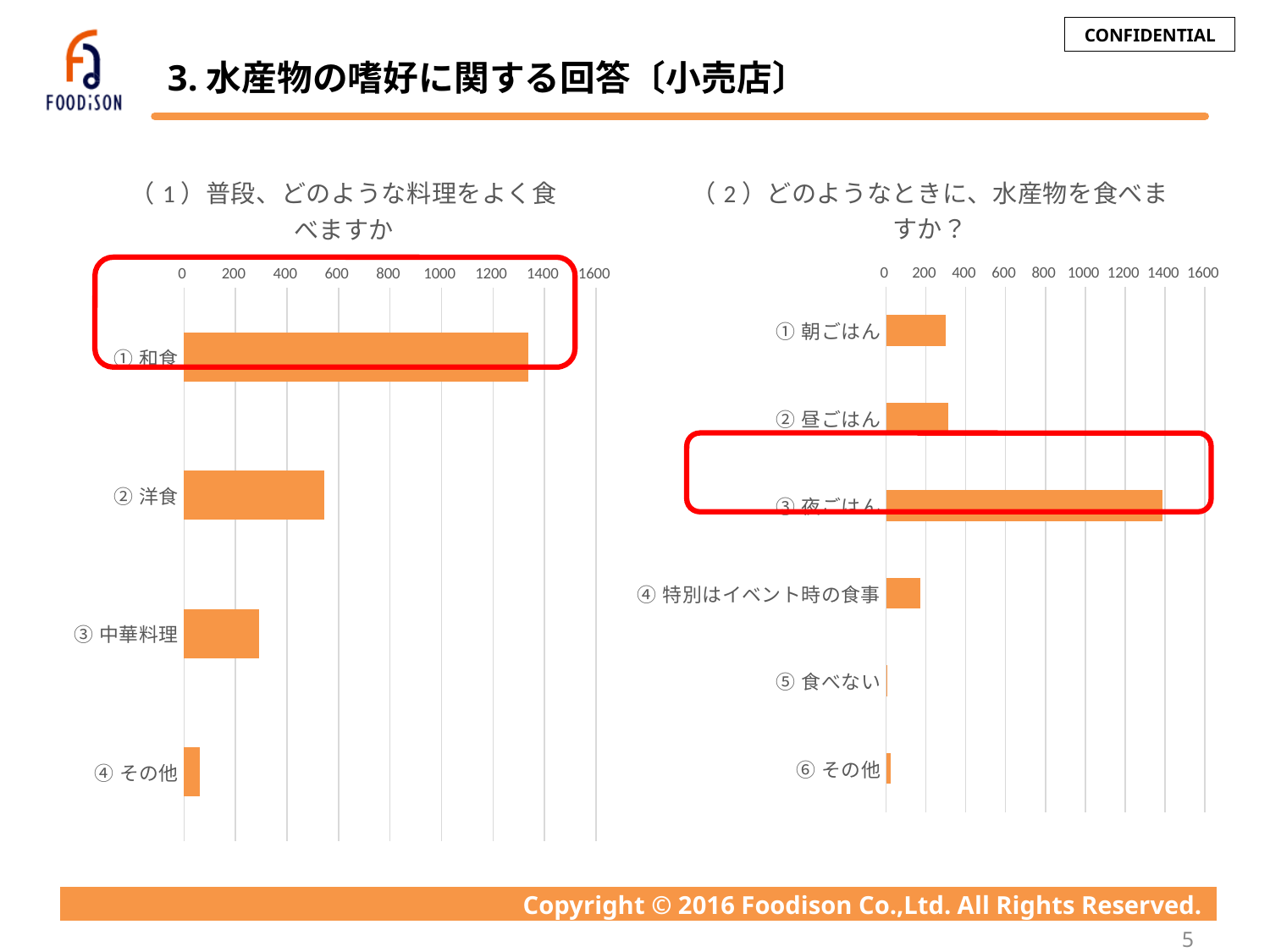
How many categories does the left chart, （1）普段、どのような料理をよく食べますか, show? 4 In the right chart, （2）どのようなときに、水産物を食べますか？, which is larger, ① 朝ごはん or ④ 特別はイベント時の食事? ① 朝ごはん How many categories does the right chart, （2）どのようなときに、水産物を食べますか？, show? 6 In the left chart, （1）普段、どのような料理をよく食べますか, is the value for ② 洋食 greater or less than 800? less In the right chart, （2）どのようなときに、水産物を食べますか？, is the value for ③ 夜ごはん greater or less than 1200? greater What is the highest value shown on the horizontal axis of the right chart, （2）どのようなときに、水産物を食べますか？? 1600 In the right chart, （2）どのようなときに、水産物を食べますか？, which category has the highest value? ③ 夜ごはん In the left chart, （1）普段、どのような料理をよく食べますか, is the value for ① 和食 greater or less than 1200? greater What kind of chart is the left chart, titled （1）普段、どのような料理をよく食べますか? bar chart In the left chart, （1）普段、どのような料理をよく食べますか, which category has the lowest value? ④ その他 In the left chart, （1）普段、どのような料理をよく食べますか, which category has the highest value? ① 和食 In the left chart, （1）普段、どのような料理をよく食べますか, which is larger, ② 洋食 or ③ 中華料理? ② 洋食